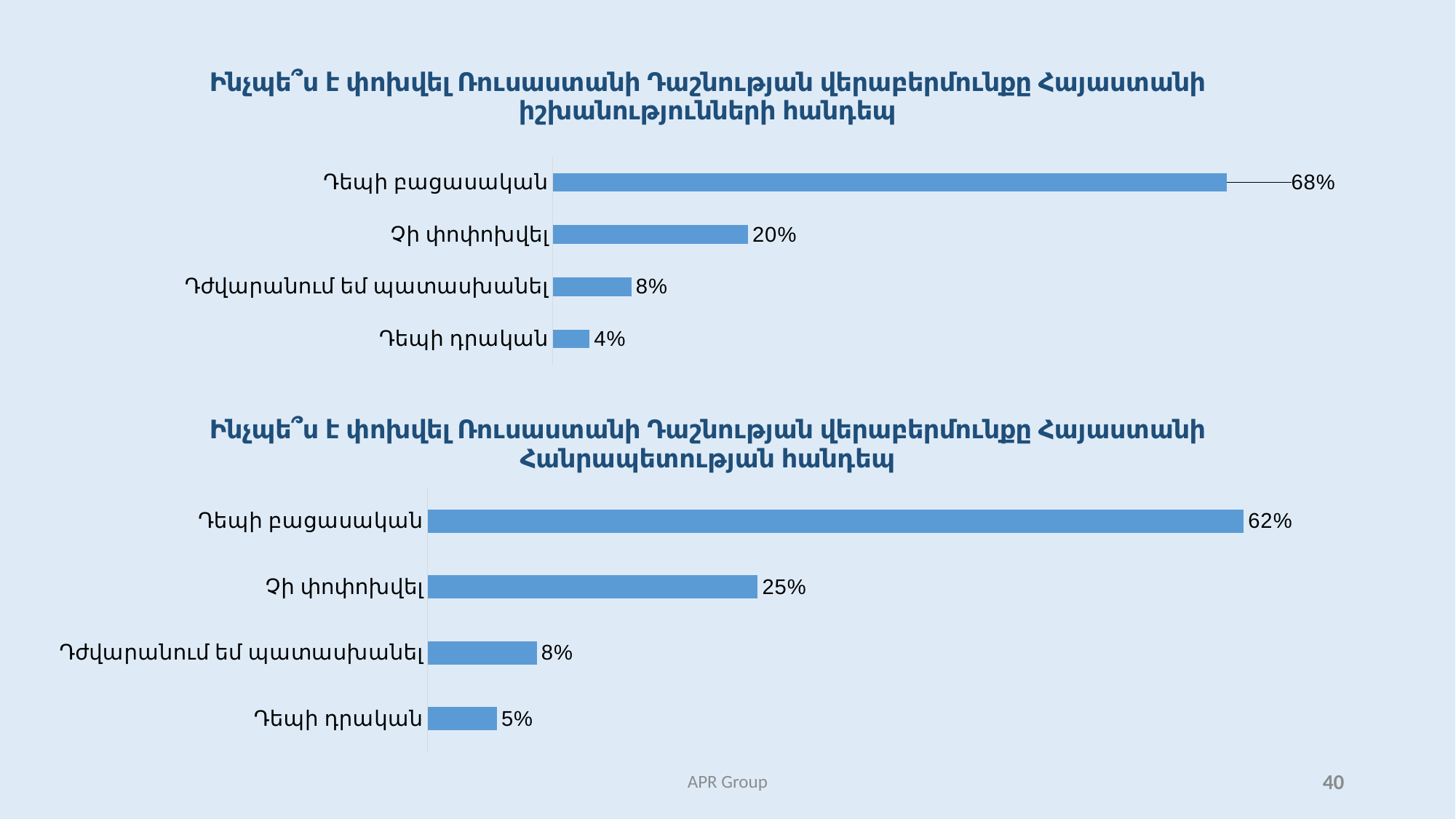
How many categories does the bottom chart (about Armenia's public) show? 4 In the top chart (about Armenia's authorities), what is the difference between Դեպի բացասական and Չի փոփոխվել? 48% In the top chart (about Armenia's authorities), which category has the highest value? Դեպի բացասական What type of chart is the top chart (about Armenia's authorities)? Bar chart In the bottom chart (about Armenia's public), what is the value for Չի փոփոխվել? 25% In the bottom chart (about Armenia's public), is the value for Դեպի դրական greater or less than Դժվարանում եմ պատասխանել? less In the top chart (about Armenia's authorities), what is the value for Չի փոփոխվել? 20% In the top chart (about Armenia's authorities), what is the value for Դեպի բացասական? 68% In the bottom chart (about Armenia's public), which category has the lowest value? Դեպի դրական In the bottom chart (about Armenia's public), what is the difference between Չի փոփոխվել and Դժվարանում եմ պատասխանել? 17% In the bottom chart (about Armenia's public), what is the value for Դեպի դրական? 5% Which is larger: Դեպի բացասական in the top chart or Դեպի բացասական in the bottom chart? Top chart (68%)